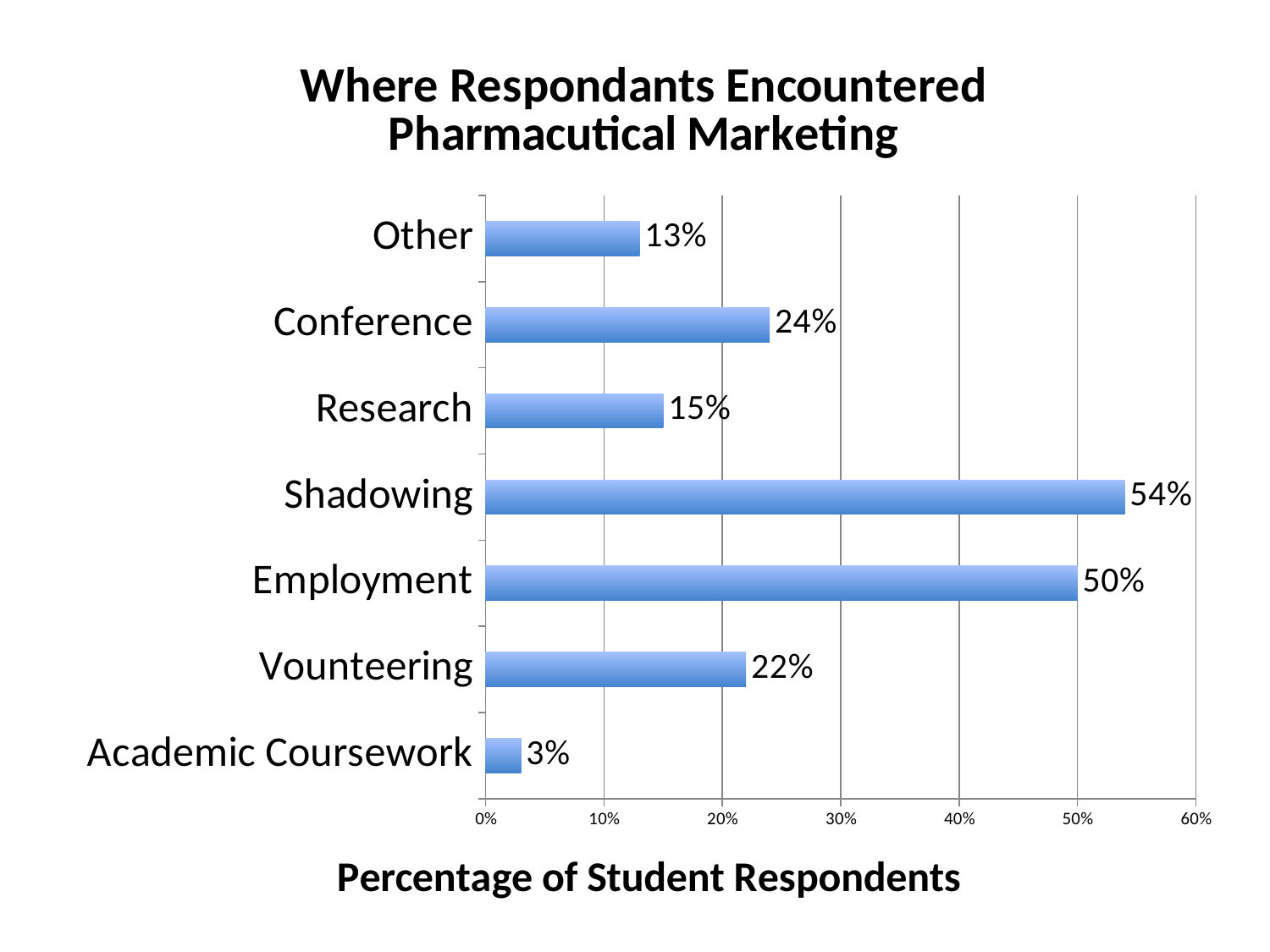
What kind of chart is shown on the slide? Bar chart What is the difference between the percentages for Shadowing and Employment? 4% What percentage is shown for Conference? 24% What percentage of student respondents encountered pharmaceutical marketing through Shadowing? 54% Is the value for Employment greater or less than 40%? greater Which category has the lowest percentage of student respondents? Academic Coursework How many categories are shown in the chart? 7 Which category has the highest percentage of student respondents? Shadowing What is the value for Academic Coursework? 3% Which is larger, the value for Vounteering or the value for Other? Vounteering What is the label of the horizontal axis? Percentage of Student Respondents What is the difference between the values for Conference and Research? 9%